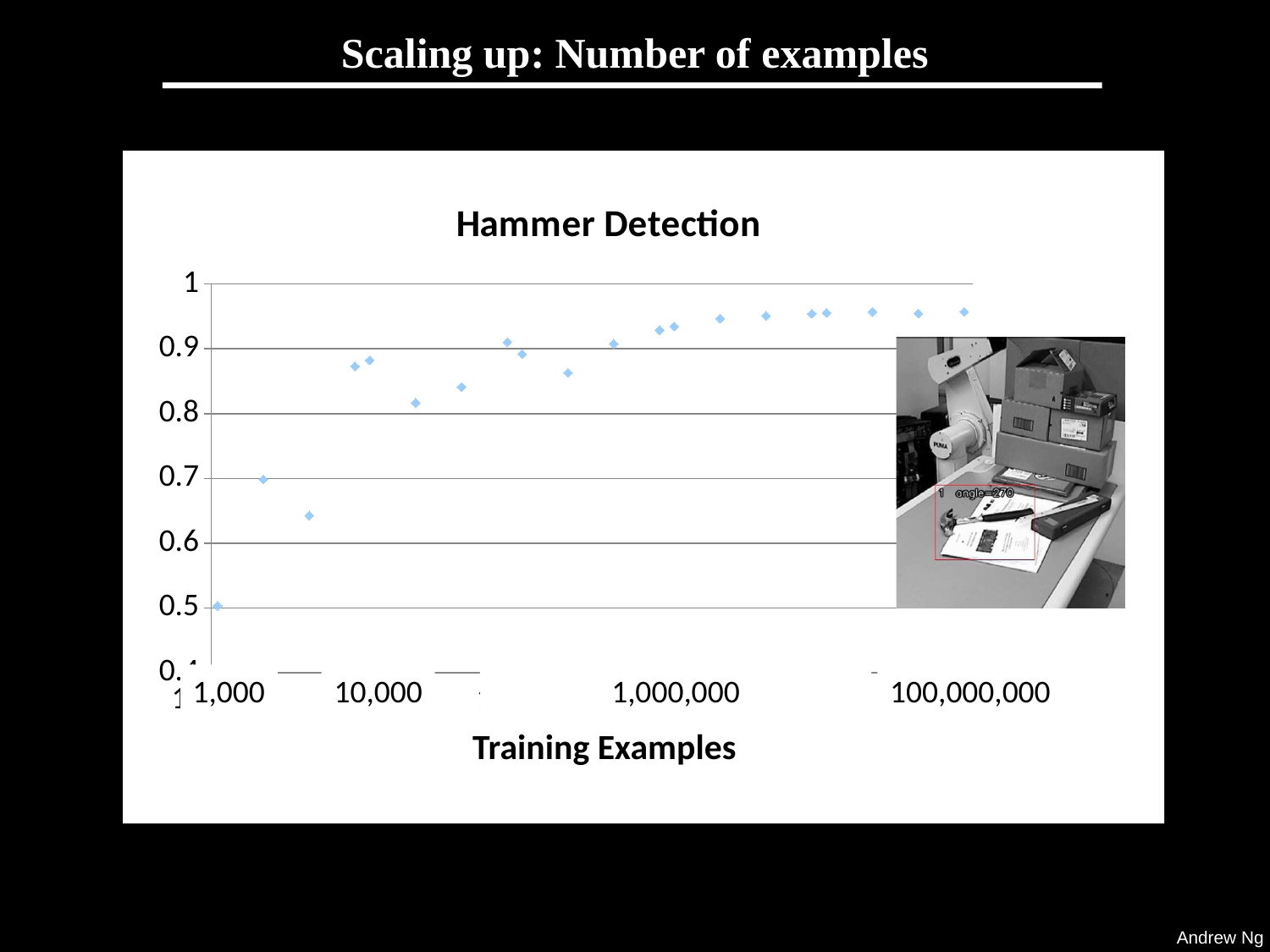
Is the value for the point at 10,000 training examples greater or less than 0.8? greater At which number of training examples is the lowest plotted value found? 1,000 Do the plotted values generally rise or fall as the number of training examples increases? rise What is the title of the chart? Hammer Detection Is the value for the leftmost point (at 1,000 training examples) greater or less than 0.6? less Which is larger: the value at 10,000 training examples or the value at 100,000,000 training examples? 100,000,000 What is the label of the x axis of the chart? Training Examples Is the value for the point at 1,000,000 training examples greater or less than 0.8? greater What kind of chart is shown on the slide? scatter chart Which is larger: the value at 1,000 training examples or the value at 1,000,000 training examples? 1,000,000